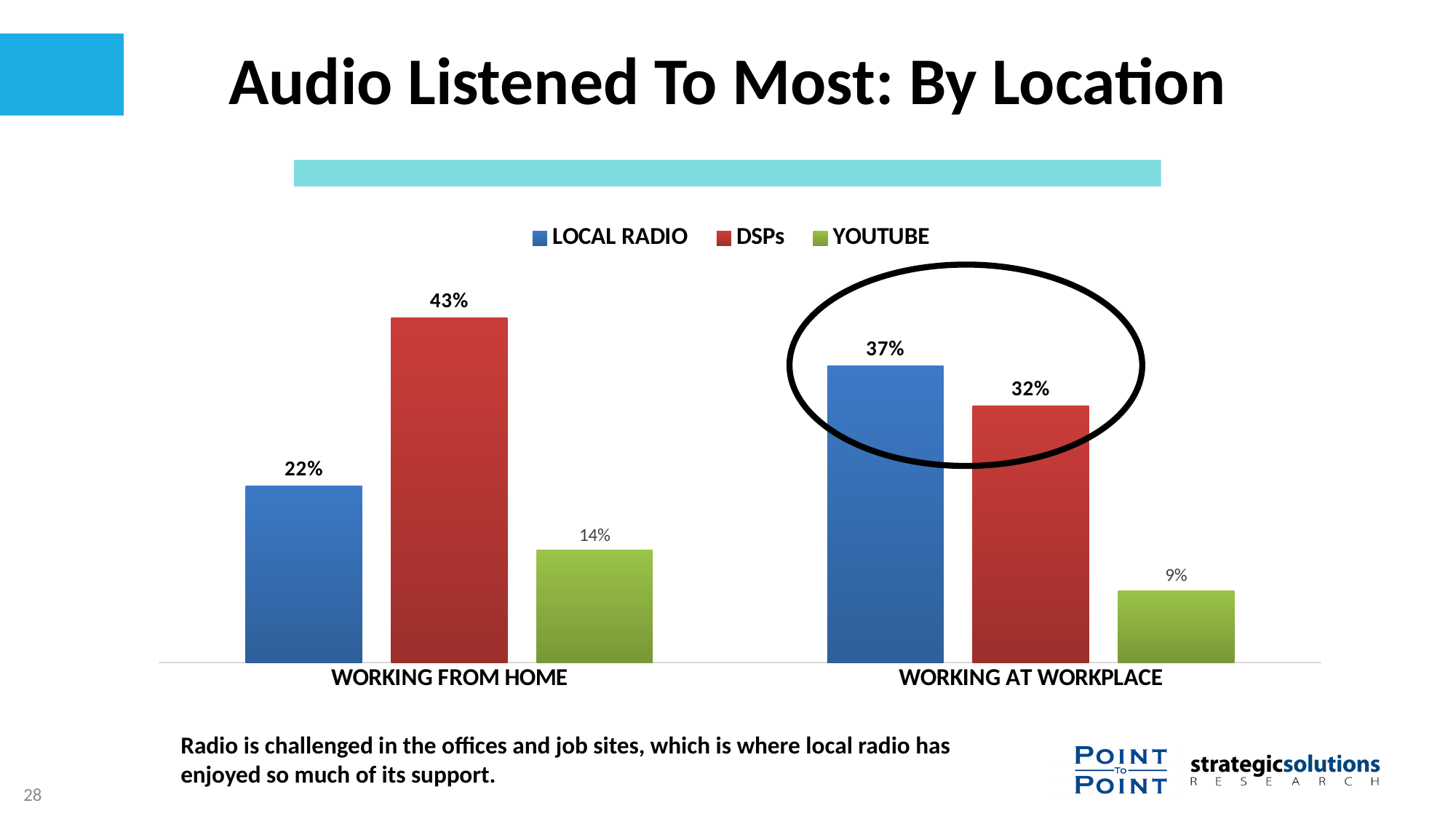
What is the value for LOCAL RADIO in the WORKING AT WORKPLACE category? 37% How many series does the legend list? 3 Which series has the highest value in the WORKING FROM HOME category? DSPs Which is larger: LOCAL RADIO for WORKING FROM HOME or LOCAL RADIO for WORKING AT WORKPLACE? WORKING AT WORKPLACE What is the difference between the LOCAL RADIO value and the DSPs value for WORKING AT WORKPLACE? 5% What is the difference between the DSPs value and the LOCAL RADIO value for WORKING FROM HOME? 21% Which series has the lowest value in the WORKING AT WORKPLACE category? YOUTUBE What kind of chart is shown on the slide? Bar chart What is the value for YOUTUBE in the WORKING FROM HOME category? 14% How many location categories are shown on the x axis? 2 What percentage of people working from home listen most to DSPs? 43% What is the value for YOUTUBE in the WORKING AT WORKPLACE category? 9%